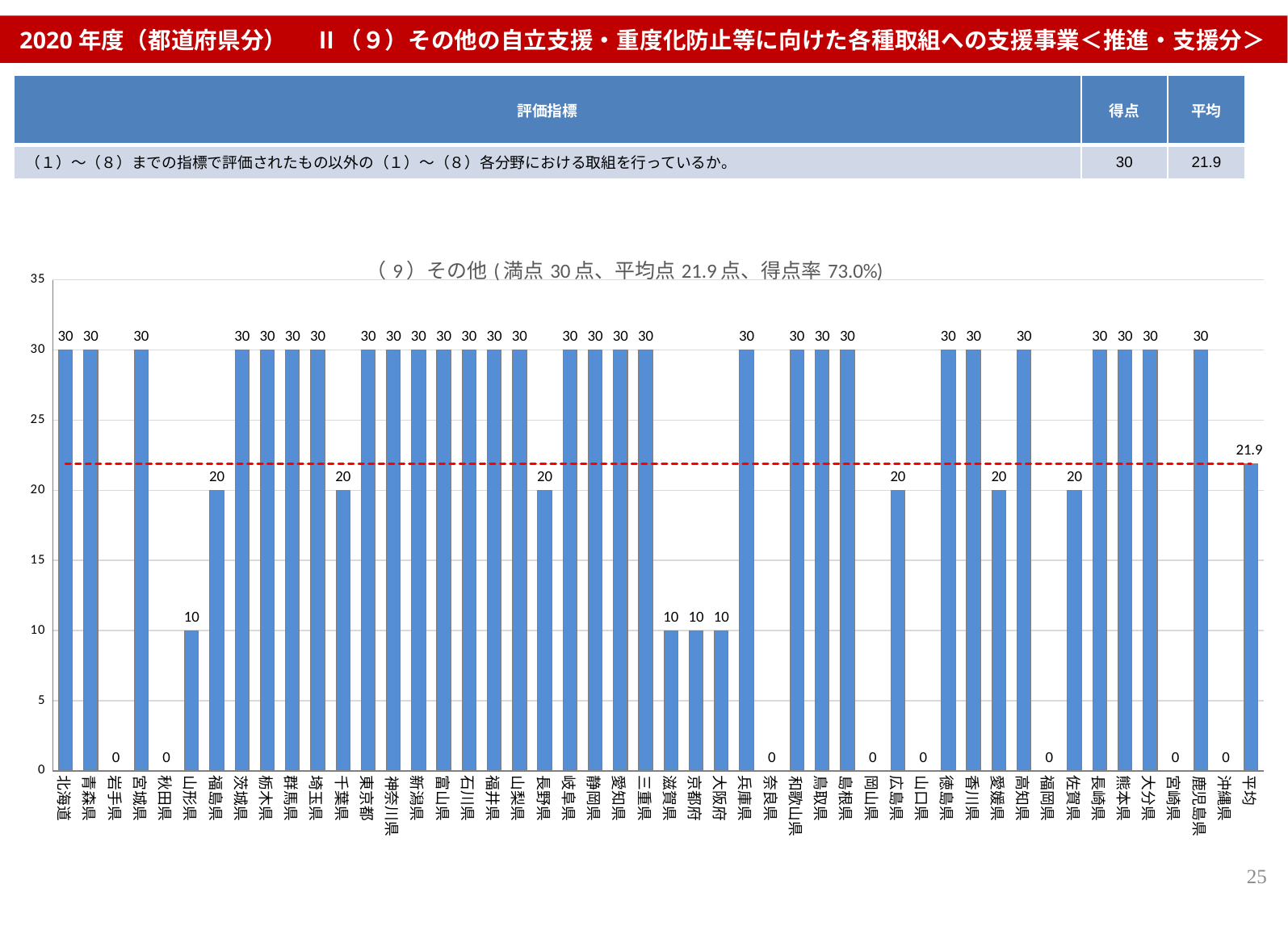
What value does the red dashed horizontal line represent? 21.9 What is the value for 平均 (the last bar)? 21.9 What kind of chart is shown on the slide? bar chart What is the lowest value shown in the chart? 0 What is the value for 福島県? 20 Is the value for 滋賀県 greater or less than 15? less What is the value for 山形県? 10 What is the value for 大阪府? 10 What is the value for 奈良県? 0 Which is larger, the value for 広島県 or the value for 京都府? 広島県 What is the difference between the values for 北海道 and 千葉県? 10 How many bars have a value of 0? 8